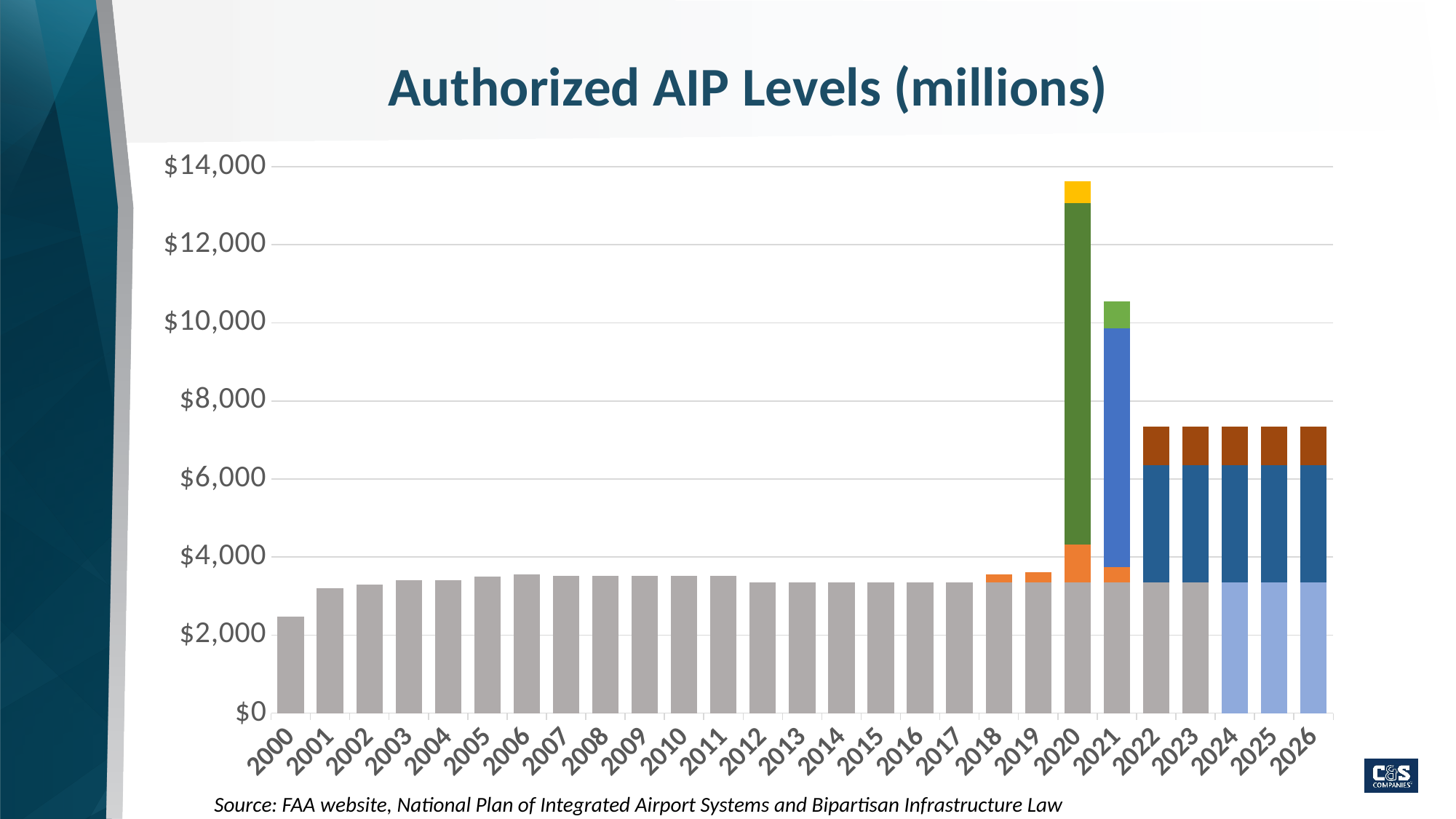
Is the total value for 2021 greater or less than $10,000? greater Is the total value for 2022 greater or less than $6,000? greater Is the total value for 2020 greater or less than $12,000? greater Which year has the highest total authorized AIP level? 2020 Which year has the lowest authorized AIP level? 2000 What kind of chart is shown on the slide? Stacked bar chart Do the total values rise, fall, or stay flat from 2022 to 2026? Stay flat What is the title of the chart? Authorized AIP Levels (millions) Which year has the larger value, 2000 or 2001? 2001 How many years are shown along the x axis of the chart? 27 Which year has the larger total, 2020 or 2021? 2020